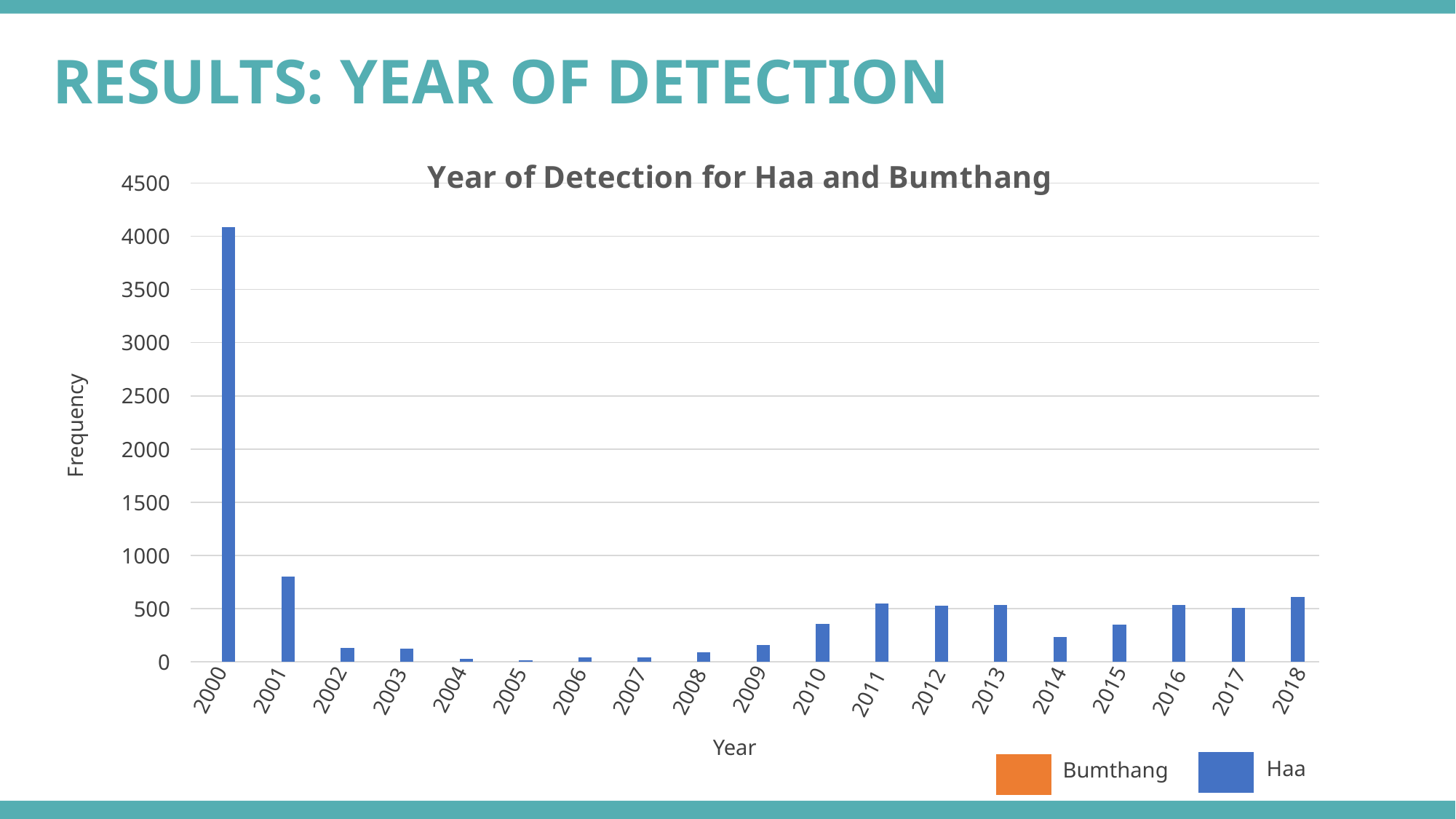
How many series does the legend list? 2 Which year has the larger frequency, 2017 or 2018? 2018 How many years are shown on the x axis? 19 Is the frequency for 2011 greater or less than 500? greater Do the frequencies rise or fall from 2000 to 2005? fall What kind of chart is shown on the slide? Bar chart What is the title of the chart? Year of Detection for Haa and Bumthang Is the frequency for 2014 greater or less than 500? less Is the frequency for 2001 greater or less than 1000? less Which year has the larger frequency, 2001 or 2002? 2001 Which year has the highest frequency? 2000